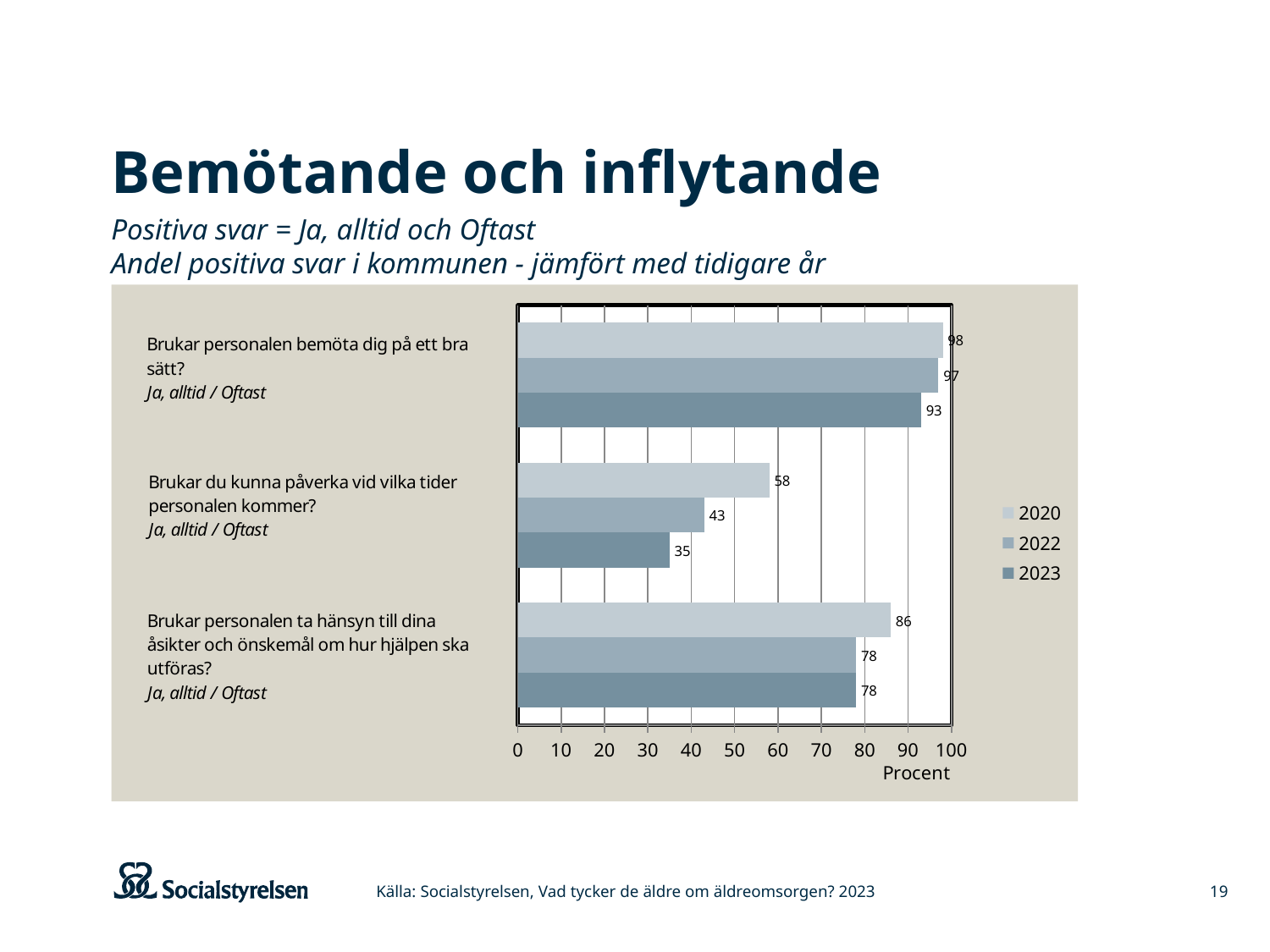
For "Brukar personalen ta hänsyn till dina åsikter och önskemål om hur hjälpen ska utföras?", which is larger, the 2020 value or the 2023 value? 2020 Do the values for "Brukar du kunna påverka vid vilka tider personalen kommer?" rise or fall from 2020 to 2023? Fall How many series does the legend list? 3 What is the 2023 value for "Brukar personalen bemöta dig på ett bra sätt?"? 93 What is the 2022 value for "Brukar personalen ta hänsyn till dina åsikter och önskemål om hur hjälpen ska utföras?"? 78 Which question has the highest 2020 value? Brukar personalen bemöta dig på ett bra sätt? What kind of chart is shown on the slide? Bar chart What is the difference between the 2020 and 2023 values for "Brukar du kunna påverka vid vilka tider personalen kommer?"? 23 Which question has the lowest 2023 value? Brukar du kunna påverka vid vilka tider personalen kommer? What is the label on the horizontal axis of the chart? Procent How many question categories are shown on the chart? 3 What is the 2020 value for "Brukar du kunna påverka vid vilka tider personalen kommer?"? 58